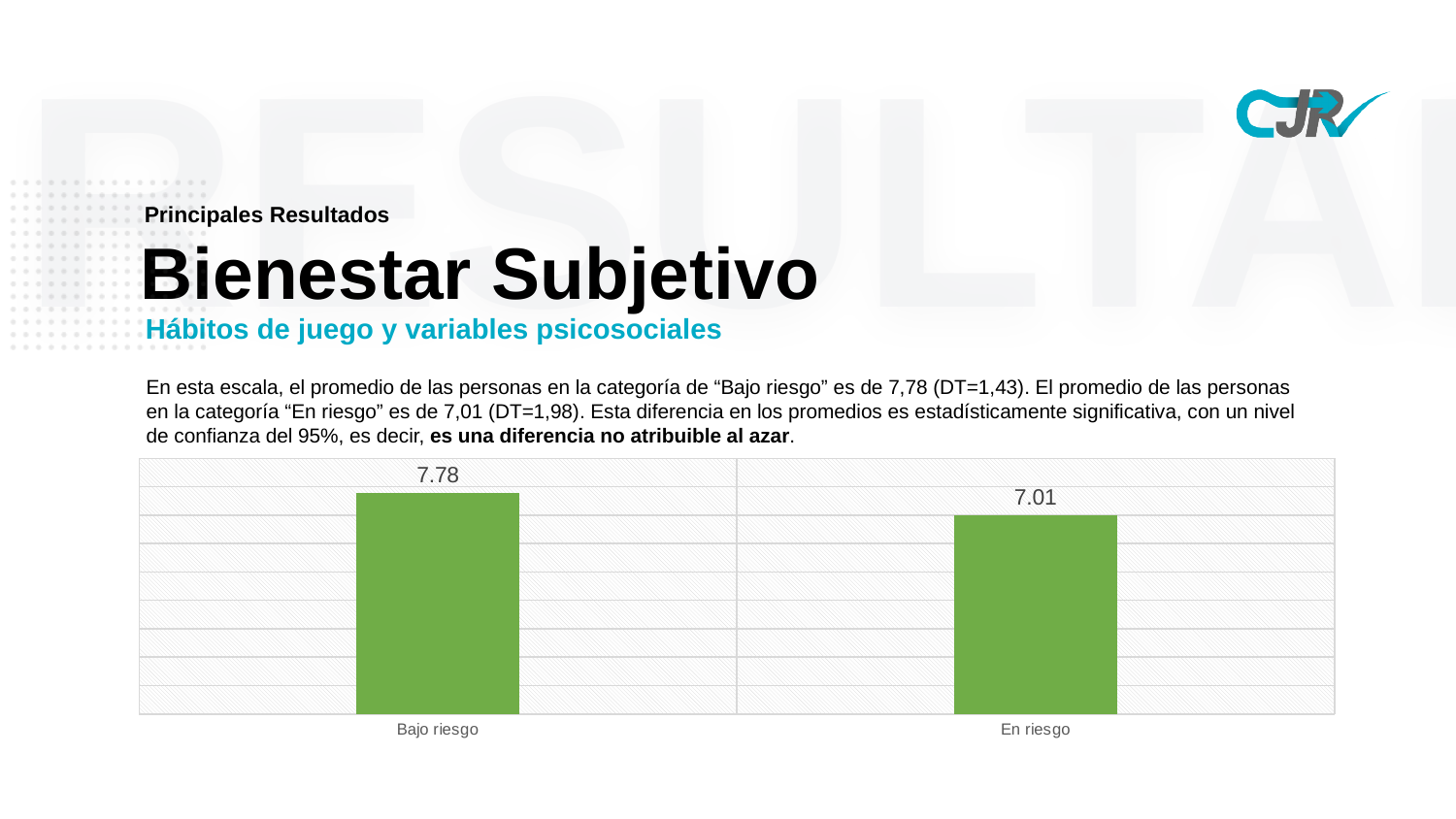
What is the value for En riesgo? 7.01 Which category has the highest value? Bajo riesgo Which is larger, the value for Bajo riesgo or the value for En riesgo? Bajo riesgo What is the value for Bajo riesgo? 7.78 What colour are the bars in the chart? green Which category has the lowest value? En riesgo Do the values rise or fall from Bajo riesgo to En riesgo? fall What kind of chart is shown on the slide? bar chart How many categories are shown in the chart? 2 What is the label of the first category on the x axis? Bajo riesgo What is the difference between the values for Bajo riesgo and En riesgo? 0.77